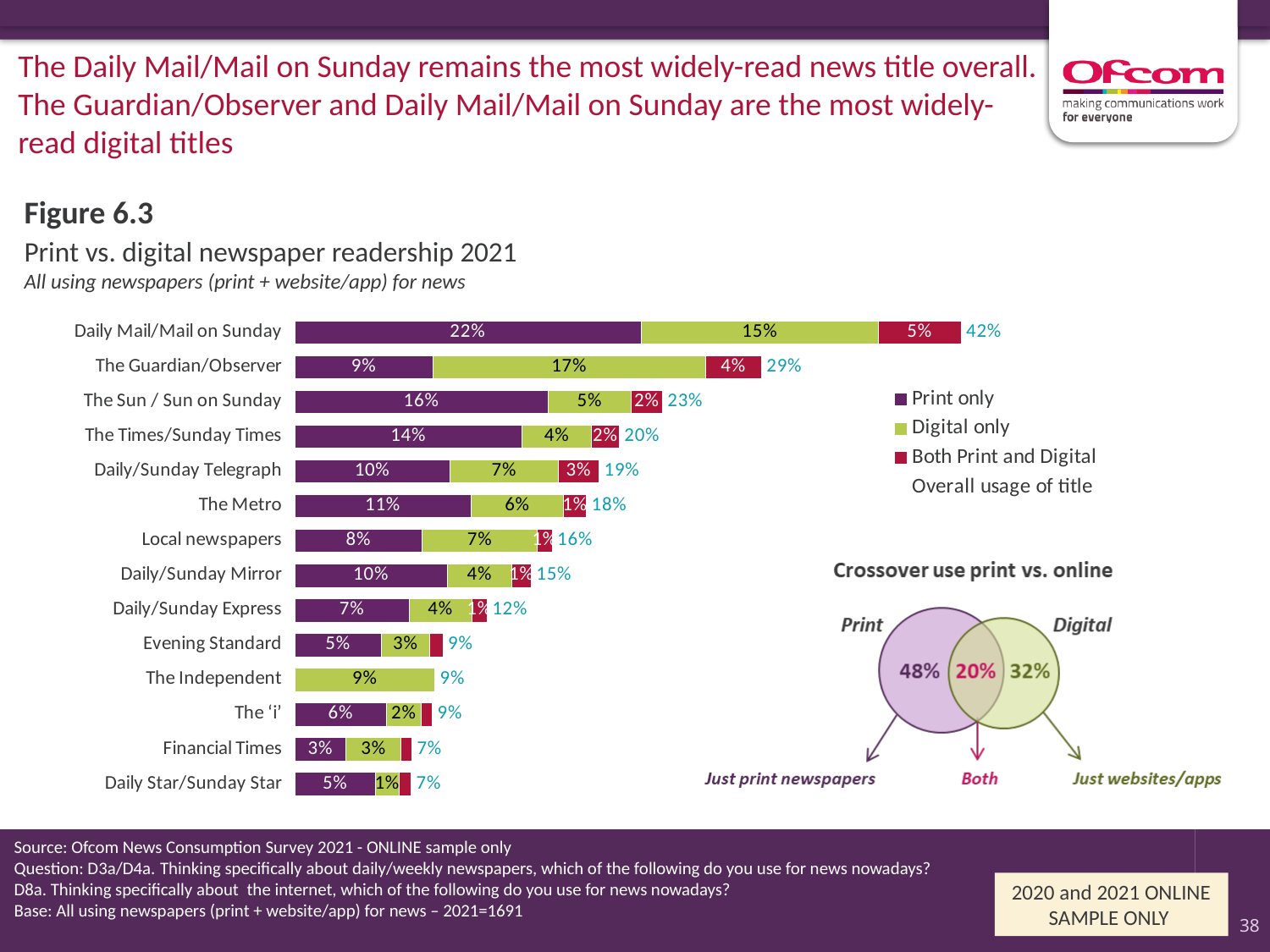
What is the overall usage figure shown for The Times/Sunday Times? 20% What is the Both Print and Digital value for Daily/Sunday Telegraph? 3% How many coloured series does the legend list? 3 Which news title has the highest overall usage? Daily Mail/Mail on Sunday What is the Digital only value for The Guardian/Observer? 17% Which news title has the highest Digital only value? The Guardian/Observer What is the difference between the overall usage of Daily Mail/Mail on Sunday and The Guardian/Observer? 13% How many news titles are listed in the bar chart? 14 What is the Print only value for Daily Mail/Mail on Sunday? 22% In the crossover use print vs. online diagram, what percentage use both print and digital? 20% Which has a larger Print only value, The Sun / Sun on Sunday or The Times/Sunday Times? The Sun / Sun on Sunday What kind of chart is used to show print vs. digital newspaper readership? Stacked bar chart